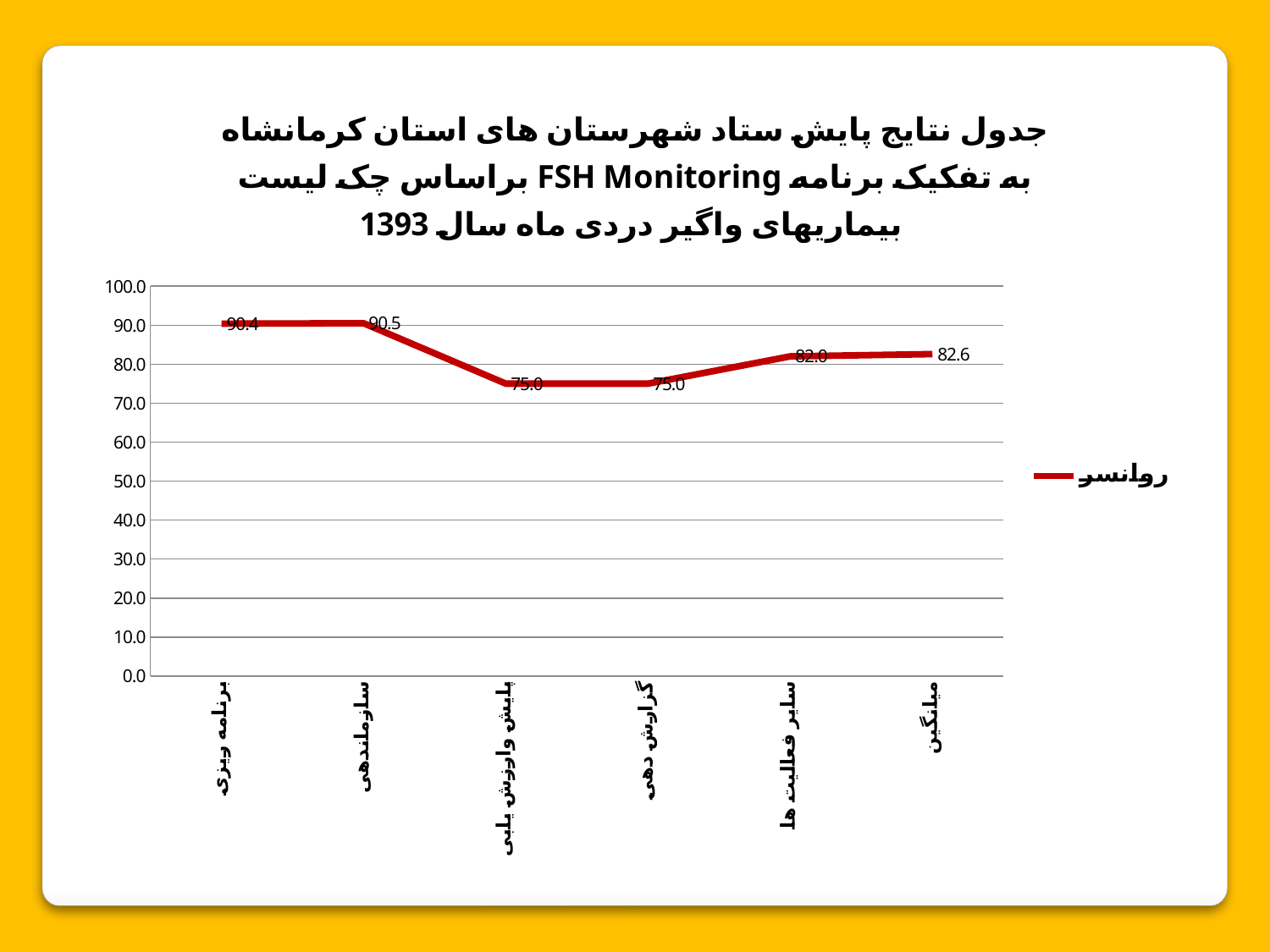
What is the value for سازماندهی? 90.5 Is the value for گزارش دهی greater or less than 80? less How many series does the legend list? 1 What kind of chart is shown on the slide? line chart Which is larger, the value for سایر فعالیت ها or the value for میانگین? میانگین What is the value for سایر فعالیت ها? 82.0 What is the value for میانگین? 82.6 What is the value for گزارش دهی? 75.0 What is the value for برنامه ریزی? 90.4 How many categories are shown on the x axis? 6 What is the difference between the values for سازماندهی and گزارش دهی? 15.5 What is the name of the series shown in the legend? روانسر